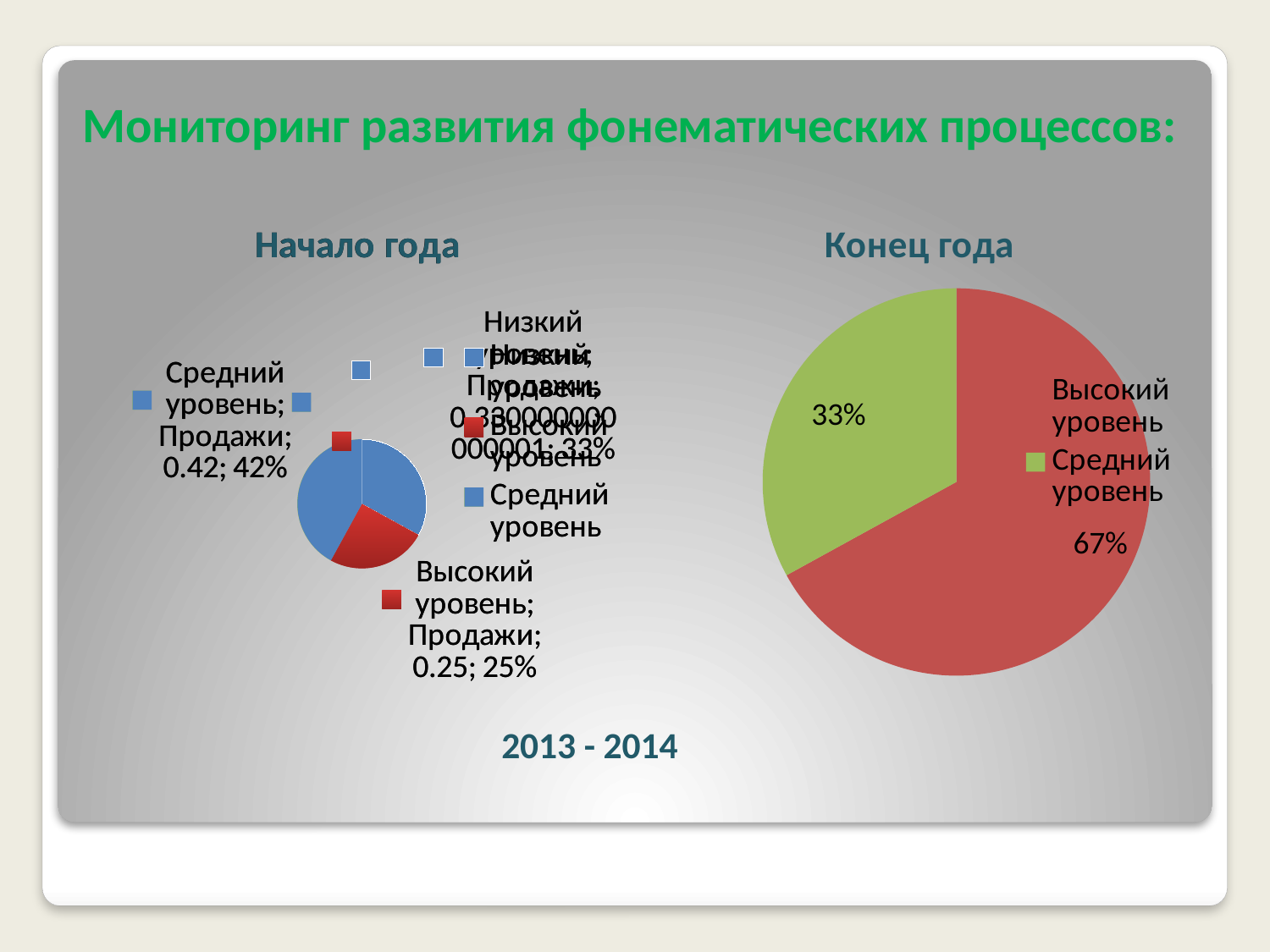
In the "Начало года" chart, what share does "Средний уровень" have? 42% What is the title of the chart on the left of the slide? Начало года In the "Начало года" chart, what share does "Высокий уровень" have? 25% In the "Начало года" chart, which is larger: "Средний уровень" or "Высокий уровень"? Средний уровень In the "Конец года" chart, what share does "Средний уровень" have? 33% How many entries does the legend of the "Конец года" chart list? 2 In the "Конец года" chart, which slice is the smallest? Средний уровень In the "Конец года" chart, what colour is the "Средний уровень" slice? green In the "Конец года" chart, which slice is the largest? Высокий уровень What kind of chart is the "Конец года" chart? pie chart In the "Конец года" chart, what is the difference in percentage points between "Высокий уровень" and "Средний уровень"? 34